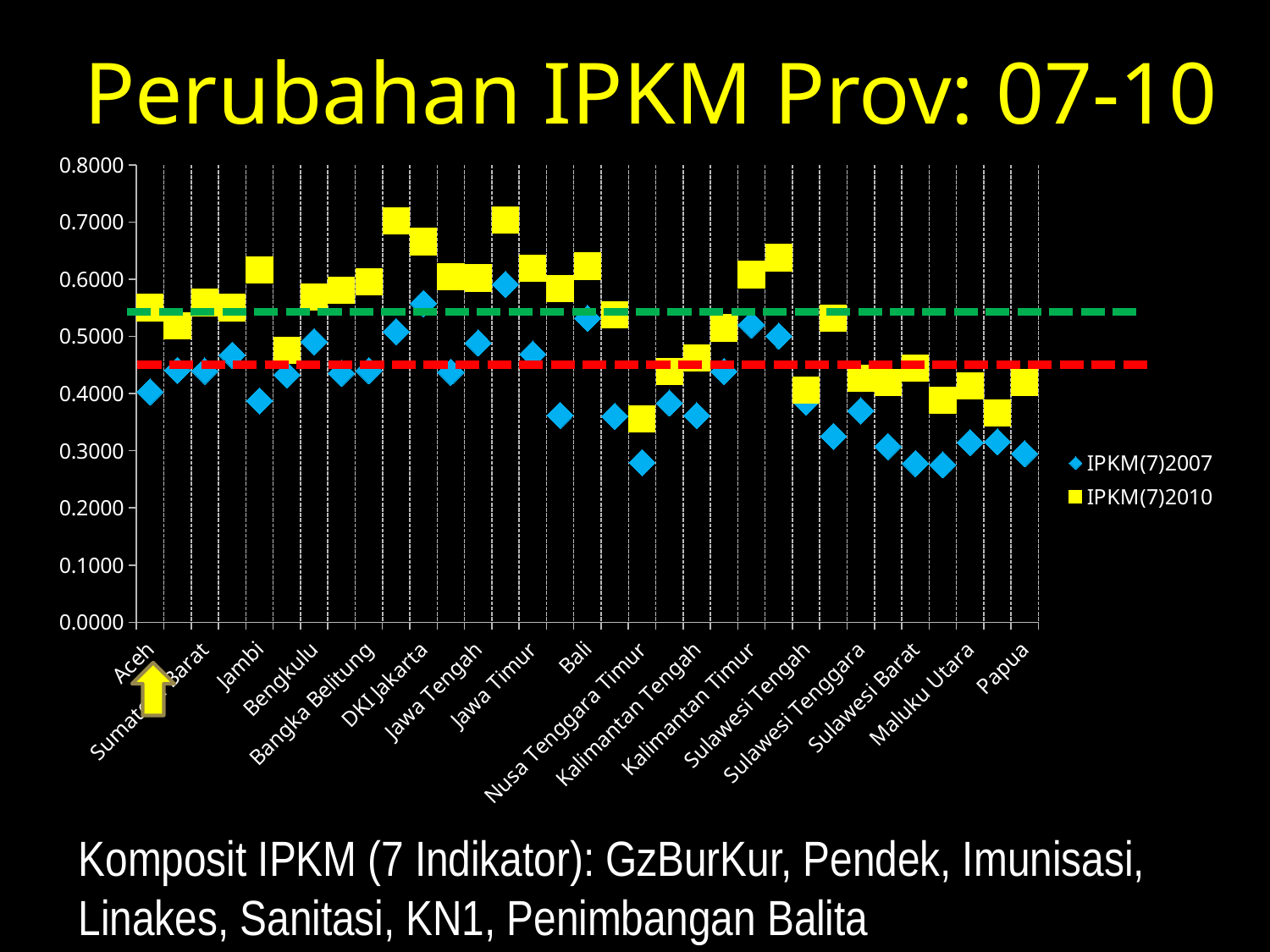
For DKI Jakarta, which is larger: the IPKM(7)2007 value or the IPKM(7)2010 value? IPKM(7)2010 Is the IPKM(7)2010 value for Nusa Tenggara Timur greater or less than 0.4000? less Is the IPKM(7)2010 value for Papua greater or less than 0.5000? less Is the IPKM(7)2010 value for DKI Jakarta greater or less than 0.6000? greater For Nusa Tenggara Timur, which is larger: the IPKM(7)2007 value or the IPKM(7)2010 value? IPKM(7)2010 What kind of chart is shown on the slide? Scatter chart What is the title of the chart? Perubahan IPKM Prov: 07-10 Which series is shown with yellow square markers? IPKM(7)2010 How many series does the legend list? 2